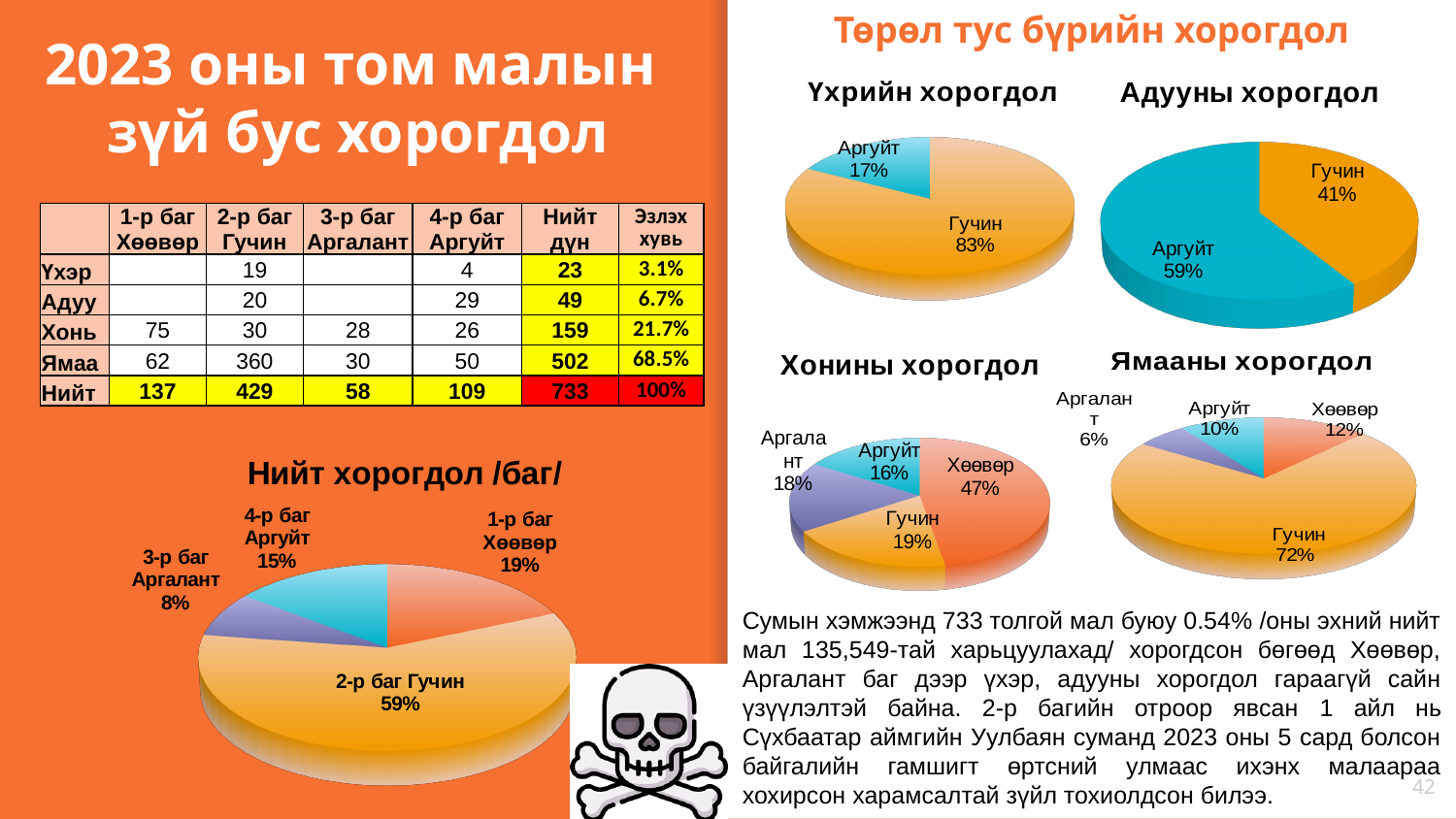
In the "Адууны хорогдол" chart, what is the difference between the Аргуйт and Гучин shares? 18% In the "Хонины хорогдол" chart, what share does Аргалант have? 18% In the "Ямааны хорогдол" chart, what share does Гучин have? 72% In the "Нийт хорогдол /баг/" chart, which slice is the smallest? 3-р баг Аргалант How many slices does the "Нийт хорогдол /баг/" pie chart have? 4 In the "Ямааны хорогдол" chart, which slice is the smallest? Аргалант How many pie charts are shown under the heading "Төрөл тус бүрийн хорогдол"? 4 What kind of chart is "Үхрийн хорогдол"? Pie chart In the "Нийт хорогдол /баг/" chart, what share does 2-р баг Гучин have? 59% In the "Үхрийн хорогдол" chart, what share does Гучин have? 83% In the "Адууны хорогдол" chart, which slice is larger, Гучин or Аргуйт? Аргуйт In the "Хонины хорогдол" chart, which slice is the largest? Хөөвөр